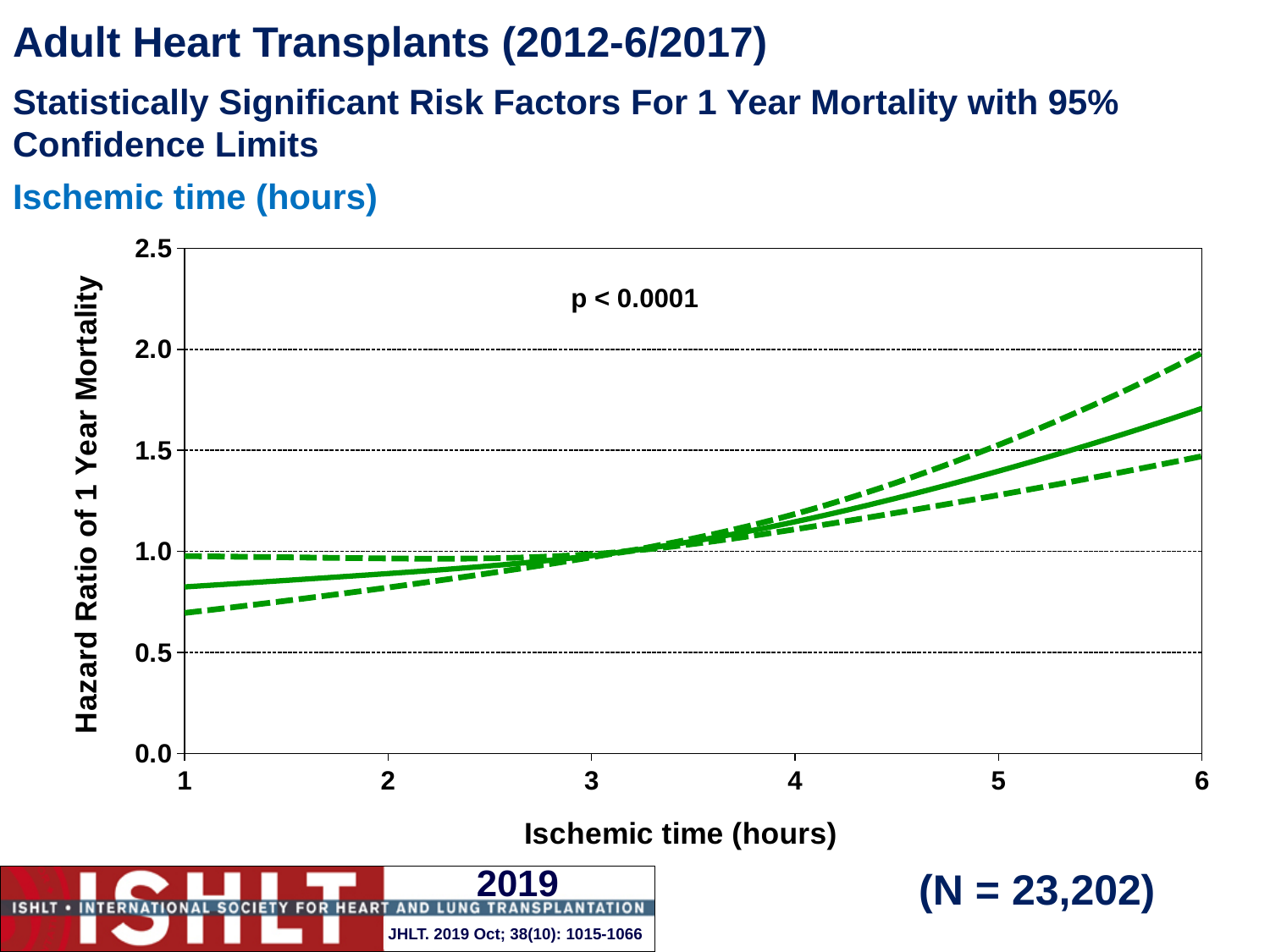
Which is larger, the hazard ratio (solid line) at 6 hours or at 1 hour of ischemic time? 6 hours Is the hazard ratio (solid line) at an ischemic time of 5 hours greater or less than 1.0? greater Is the hazard ratio (solid line) at an ischemic time of 2 hours greater or less than 1.0? less Is the hazard ratio (solid line) at an ischemic time of 6 hours greater or less than 1.5? greater What is the label of the y axis? Hazard Ratio of 1 Year Mortality Does the hazard ratio of 1 year mortality rise or fall as ischemic time increases from 1 to 6 hours? rise What kind of chart is shown on the slide? line chart How many tick values are labeled on the x axis (ischemic time)? 6 What p-value is printed on the chart? p < 0.0001